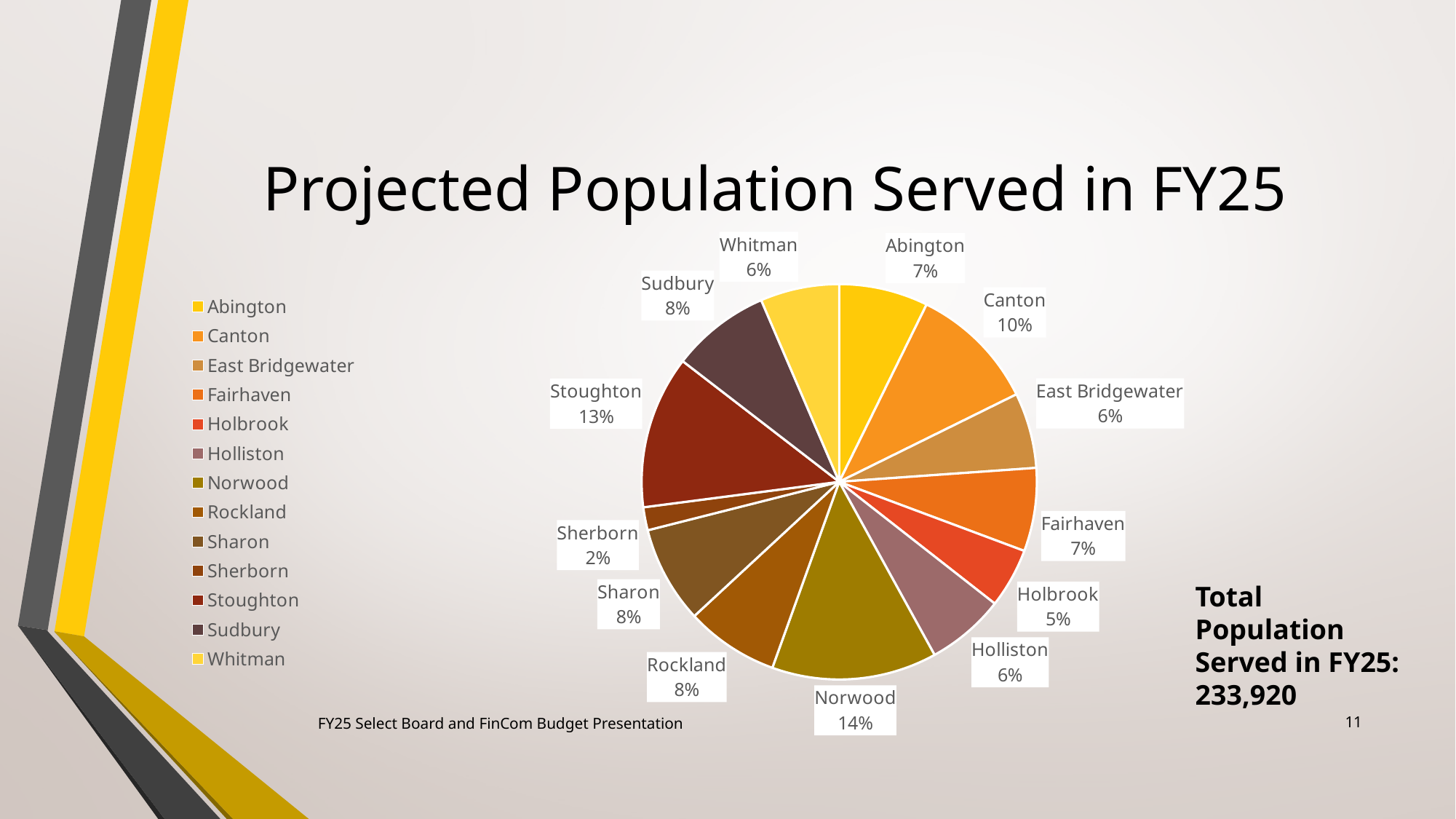
What is the difference in percentage points between Canton and Holbrook? 5 What kind of chart is shown on the slide? pie chart Which town has the smallest slice of the pie? Sherborn Which has a larger share, Canton or Sudbury? Canton What is the difference in percentage points between Norwood and Stoughton? 1 Which town has the largest slice of the pie? Norwood What percentage is shown for Stoughton? 13% What percentage is shown for Canton? 10% What is the title of the chart? Projected Population Served in FY25 What total population served in FY25 is stated on the slide? 233,920 What share of the projected population served in FY25 does Norwood account for? 14% How many towns are shown in the pie chart? 13